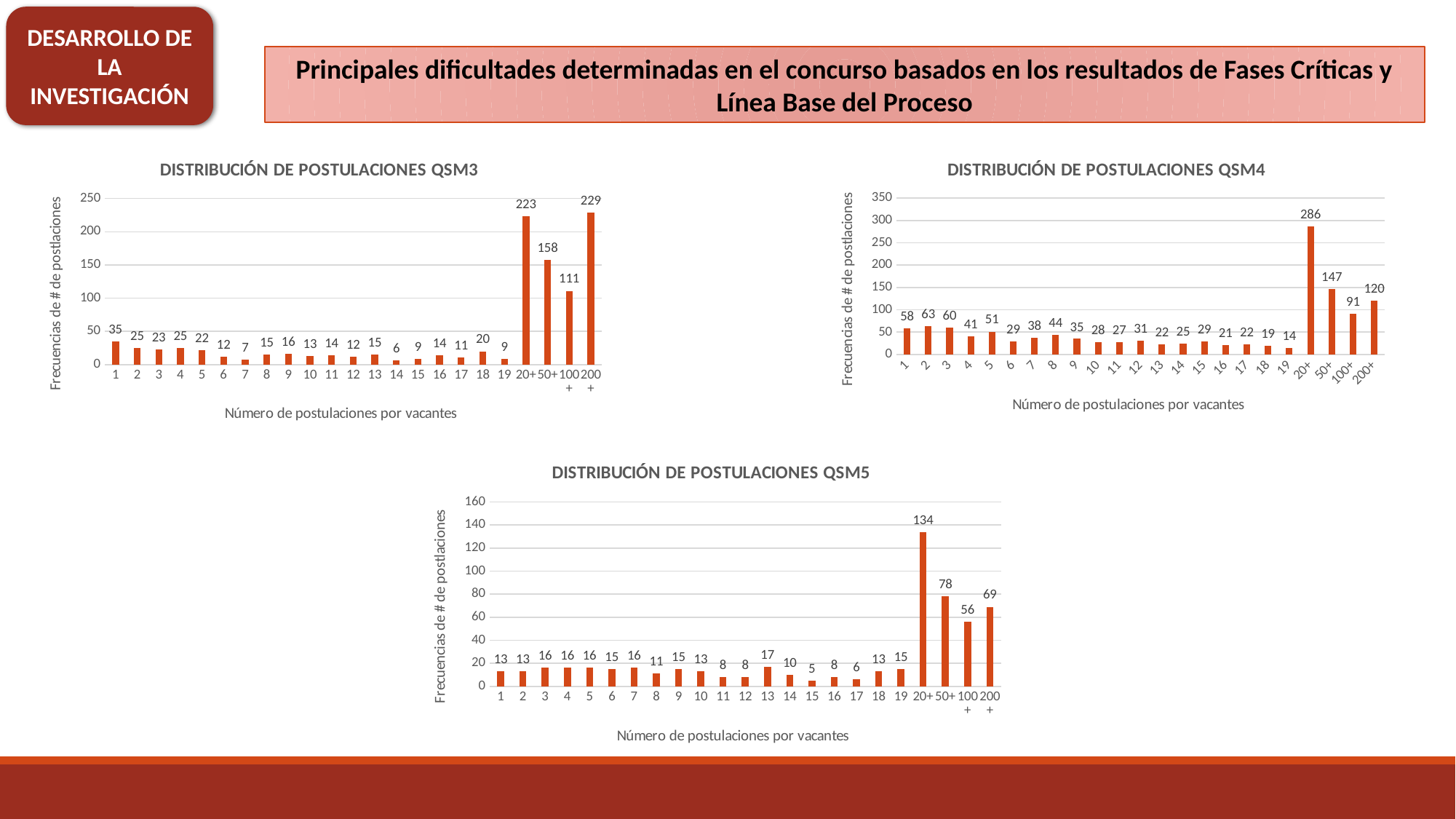
In the 'DISTRIBUCIÓN DE POSTULACIONES QSM4' chart, which category has the lowest value? 19 In the 'DISTRIBUCIÓN DE POSTULACIONES QSM3' chart, which category has the lowest value? 14 In the 'DISTRIBUCIÓN DE POSTULACIONES QSM4' chart, what is the value for category 20+? 286 In the 'DISTRIBUCIÓN DE POSTULACIONES QSM4' chart, what is the difference between the values for 2 and 1? 5 How many categories are shown on the x axis of the 'DISTRIBUCIÓN DE POSTULACIONES QSM5' chart? 23 In the 'DISTRIBUCIÓN DE POSTULACIONES QSM5' chart, what is the value for category 50+? 78 In the 'DISTRIBUCIÓN DE POSTULACIONES QSM3' chart, which category has the highest value? 200+ In the 'DISTRIBUCIÓN DE POSTULACIONES QSM3' chart, what is the value for category 20+? 223 In the 'DISTRIBUCIÓN DE POSTULACIONES QSM5' chart, which category has the highest value? 20+ In the 'DISTRIBUCIÓN DE POSTULACIONES QSM4' chart, which is larger, the value for 50+ or the value for 200+? 50+ What kind of chart is 'DISTRIBUCIÓN DE POSTULACIONES QSM5'? Bar chart In the 'DISTRIBUCIÓN DE POSTULACIONES QSM3' chart, what is the difference between the values for 200+ and 20+? 6